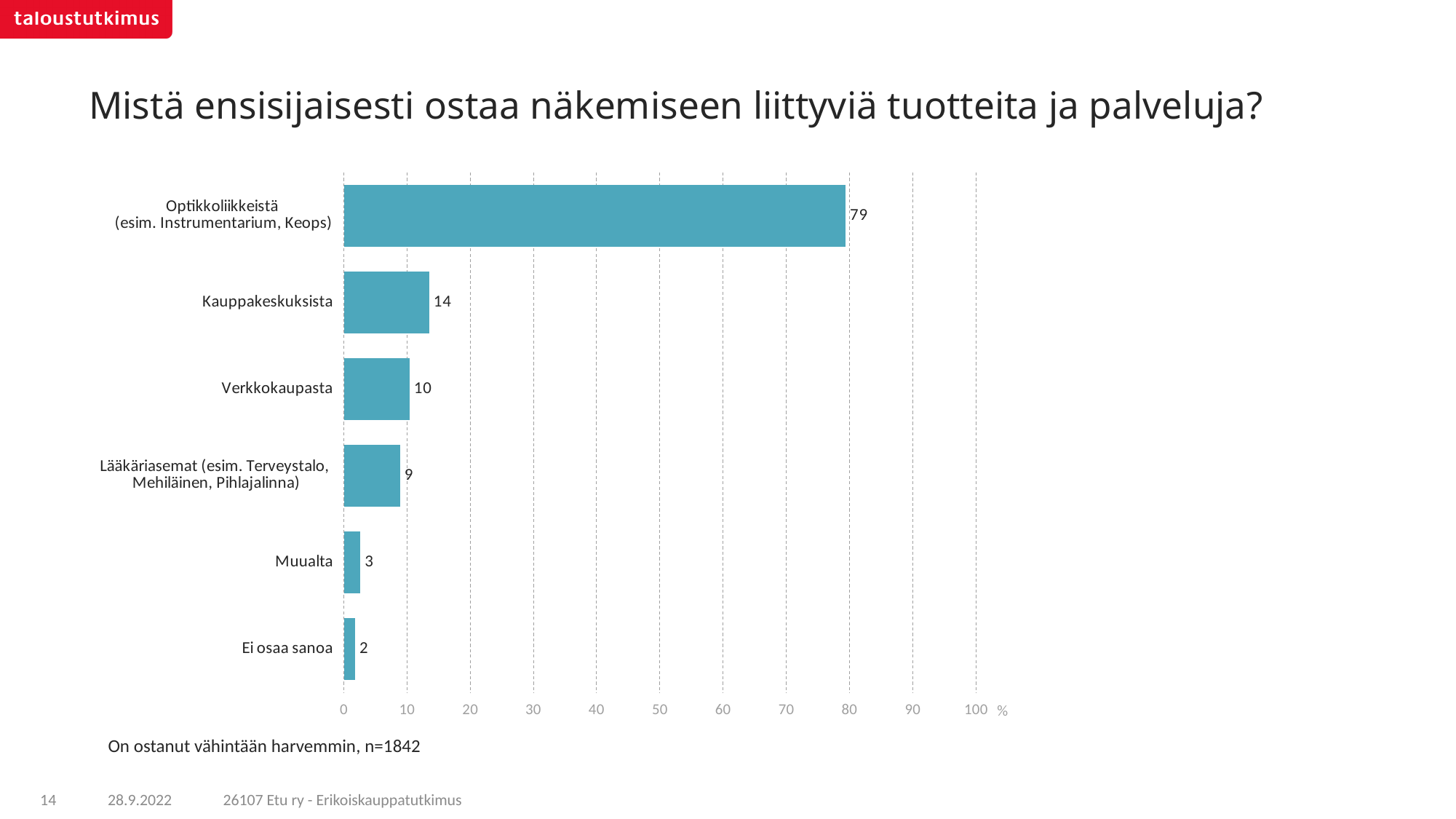
What is the value for Ei osaa sanoa? 2 What is the value for Kauppakeskuksista? 14 What is the difference between the values for Optikkoliikkeistä and Kauppakeskuksista? 65 How many categories are shown in the chart? 6 What is the sample size stated below the chart? n=1842 What is the value for Optikkoliikkeistä (esim. Instrumentarium, Keops)? 79 What is the value for Lääkäriasemat (esim. Terveystalo, Mehiläinen, Pihlajalinna)? 9 What is the value for Verkkokaupasta? 10 Which is larger, the value for Verkkokaupasta or the value for Muualta? Verkkokaupasta Which category has the lowest value? Ei osaa sanoa Which category has the highest value? Optikkoliikkeistä (esim. Instrumentarium, Keops) What kind of chart is shown on the slide? Bar chart